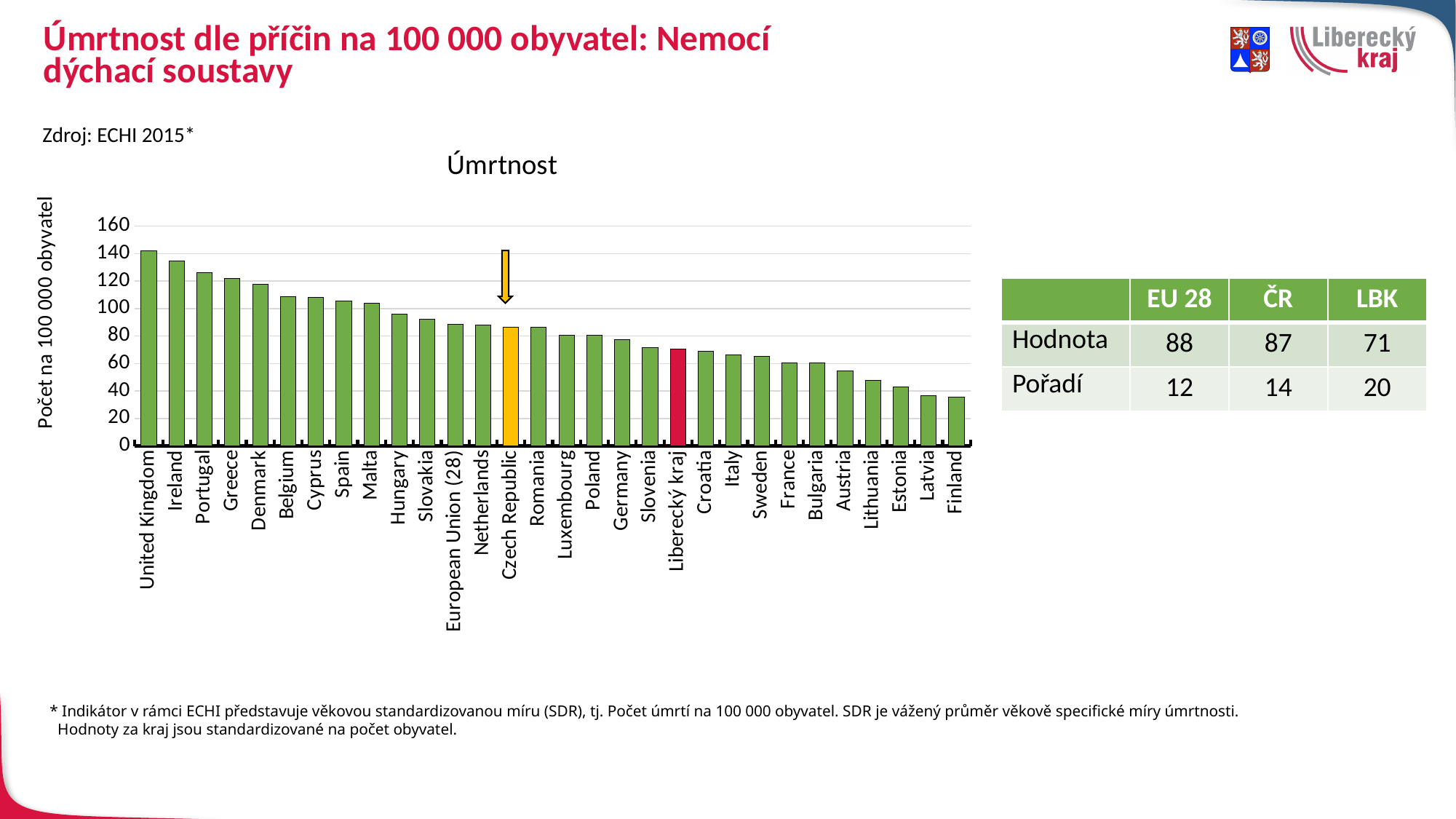
Do the values rise or fall from left to right along the x axis? fall According to the table, what is the value (Hodnota) for Liberecký kraj (LBK)? 71 Which has the larger value, Czech Republic or Liberecký kraj? Czech Republic What is the difference between the EU 28 value and the LBK value shown in the table? 17 Is the value for Finland greater or less than 40? less What is the title of the chart? Úmrtnost According to the table, what is the value (Hodnota) for EU 28? 88 What kind of chart is shown on the slide? bar chart According to the table, what is the value (Hodnota) for the Czech Republic (ČR)? 87 How many countries/regions are plotted on the chart? 30 Which country has the highest mortality value on the chart? United Kingdom Is the value for United Kingdom greater or less than 120? greater